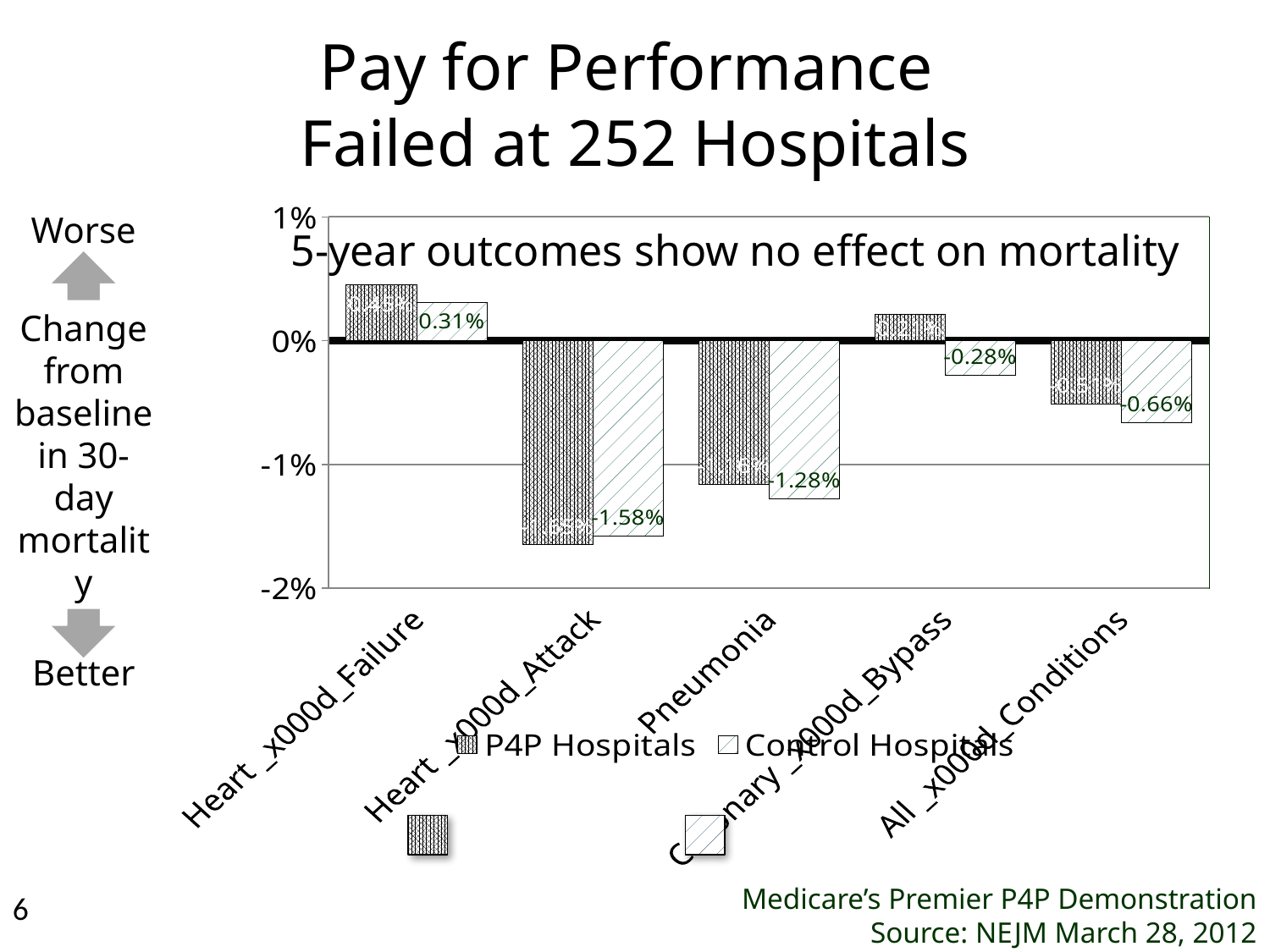
What is the value for Control Hospitals for Heart Attack? -1.58% How many series does the chart legend list? 2 What kind of chart is shown on the slide? Bar chart What is the difference between the Control Hospitals values for Pneumonia and Heart Attack? 0.30% What is the value for Control Hospitals for Pneumonia? -1.28% What is the value for Control Hospitals for Heart Failure? 0.31% What is the value for Control Hospitals for Coronary Bypass? -0.28% What is the value for Control Hospitals for All Conditions? -0.66% How many condition categories are plotted on the x axis? 5 Is the value for P4P Hospitals for Heart Attack greater or less than -1%? less What is the title shown inside the chart area? 5-year outcomes show no effect on mortality Which category has the lowest value for Control Hospitals? Heart Attack